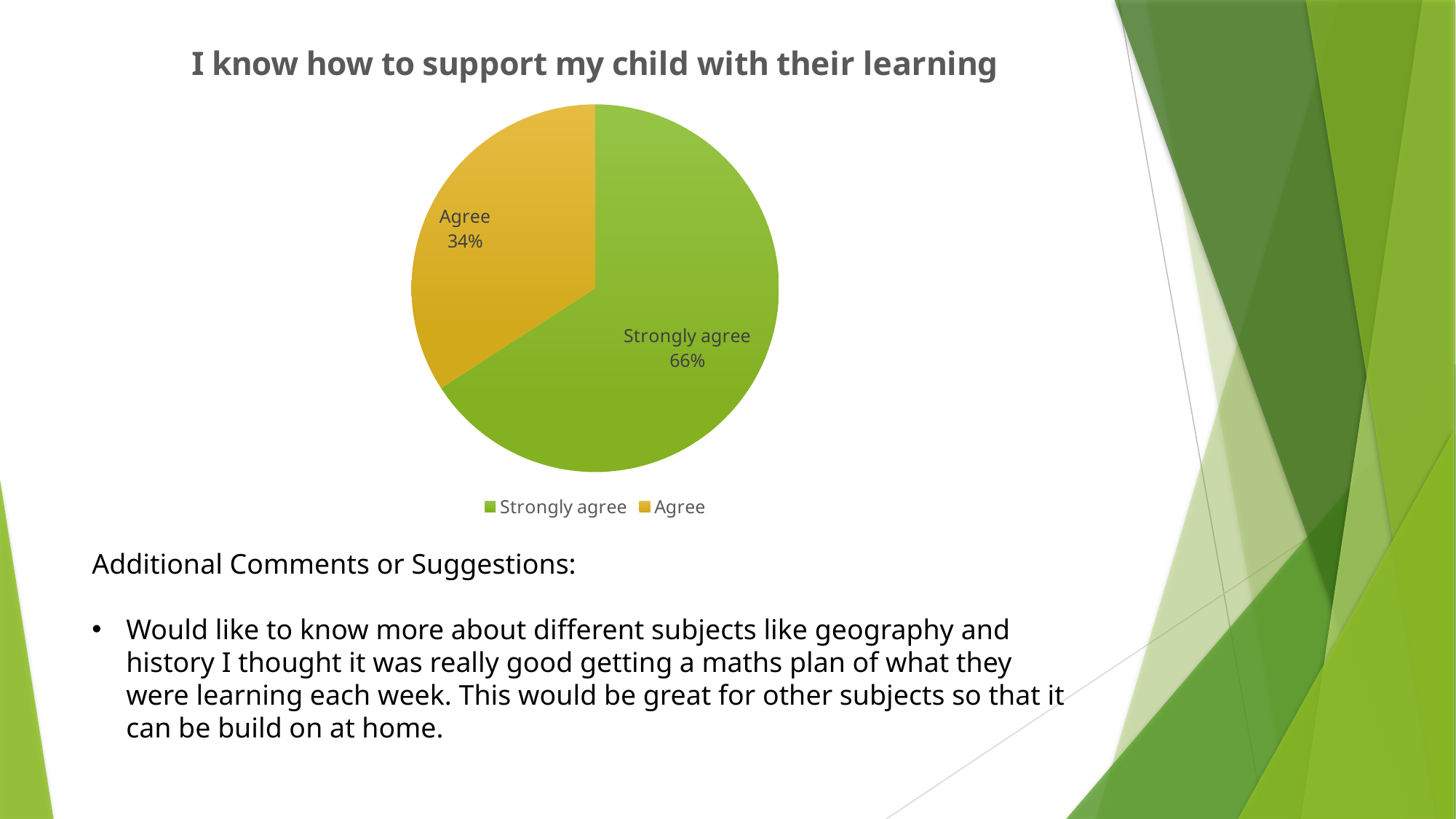
How many entries does the legend list? 2 What share of the pie does the 'Strongly agree' slice represent? 66% What kind of chart is shown on the slide? Pie chart Which response has the smallest share of the pie? Agree Which response has the largest share of the pie? Strongly agree How many slices does the pie chart have? 2 What is the title of the chart? I know how to support my child with their learning Which is larger, the share for 'Strongly agree' or the share for 'Agree'? Strongly agree What is the difference in percentage points between 'Strongly agree' and 'Agree'? 32 What colour is the 'Agree' slice? Yellow/orange What percentage of respondents chose 'Agree'? 34% What percentage of respondents chose 'Strongly agree'? 66%